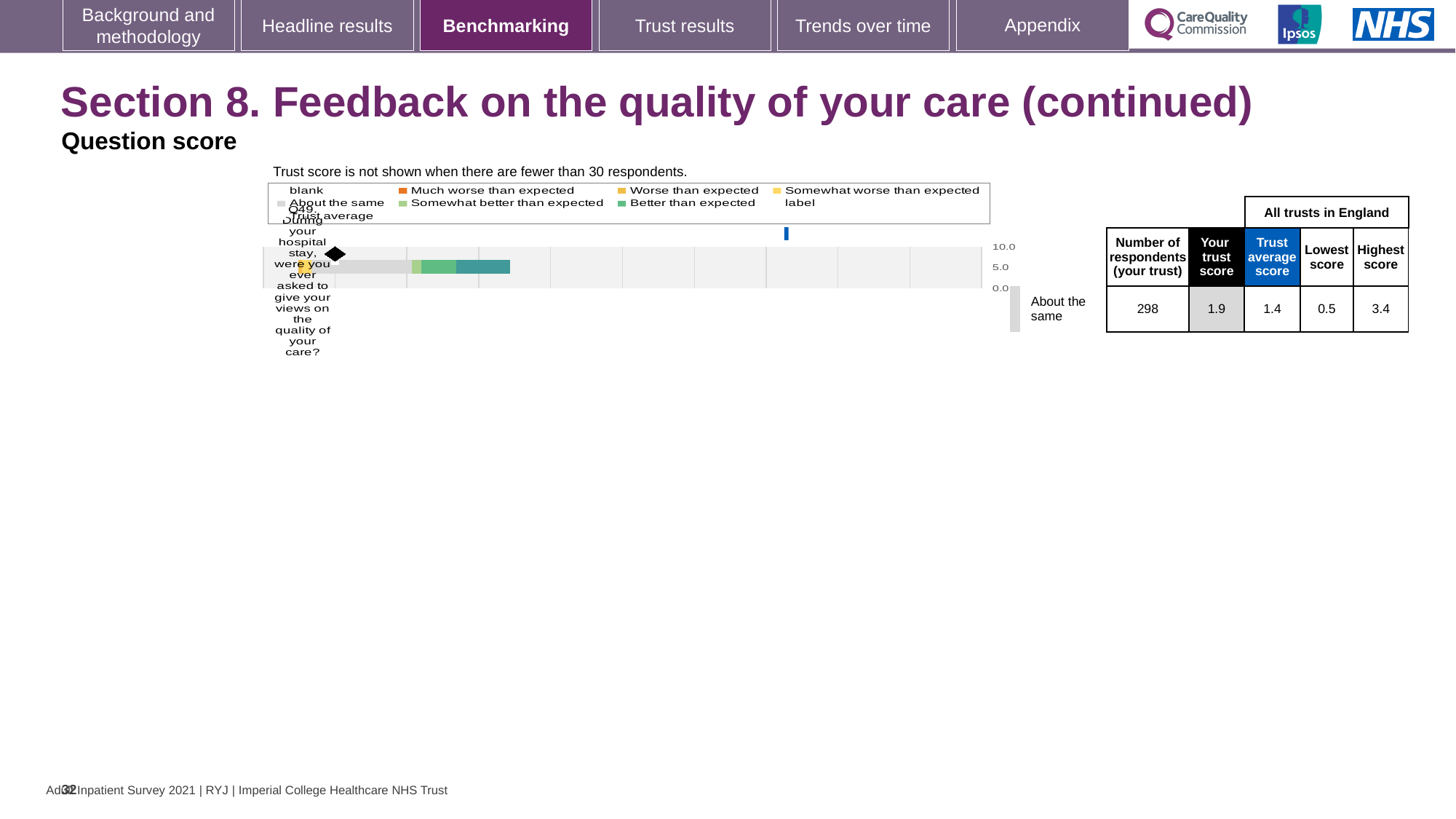
According to the table next to the chart, what is the lowest score among all trusts in England? 0.5 Which question number is plotted in the chart? Q49 According to the table next to the chart, what is your trust score for Q49? 1.9 Which is larger for Q49: your trust score or the trust average score? Your trust score According to the table next to the chart, what is the highest score among all trusts in England? 3.4 What is the difference between your trust score and the trust average score for Q49? 0.5 According to the table next to the chart, what is the trust average score for Q49? 1.4 How many questions (categories) are plotted in the chart? 1 According to the table next to the chart, what is the number of respondents for your trust? 298 What benchmark category label is shown beside the chart for Q49? About the same What kind of chart is shown on the slide? bar chart What is the difference between the highest score and the lowest score among all trusts in England for Q49? 2.9